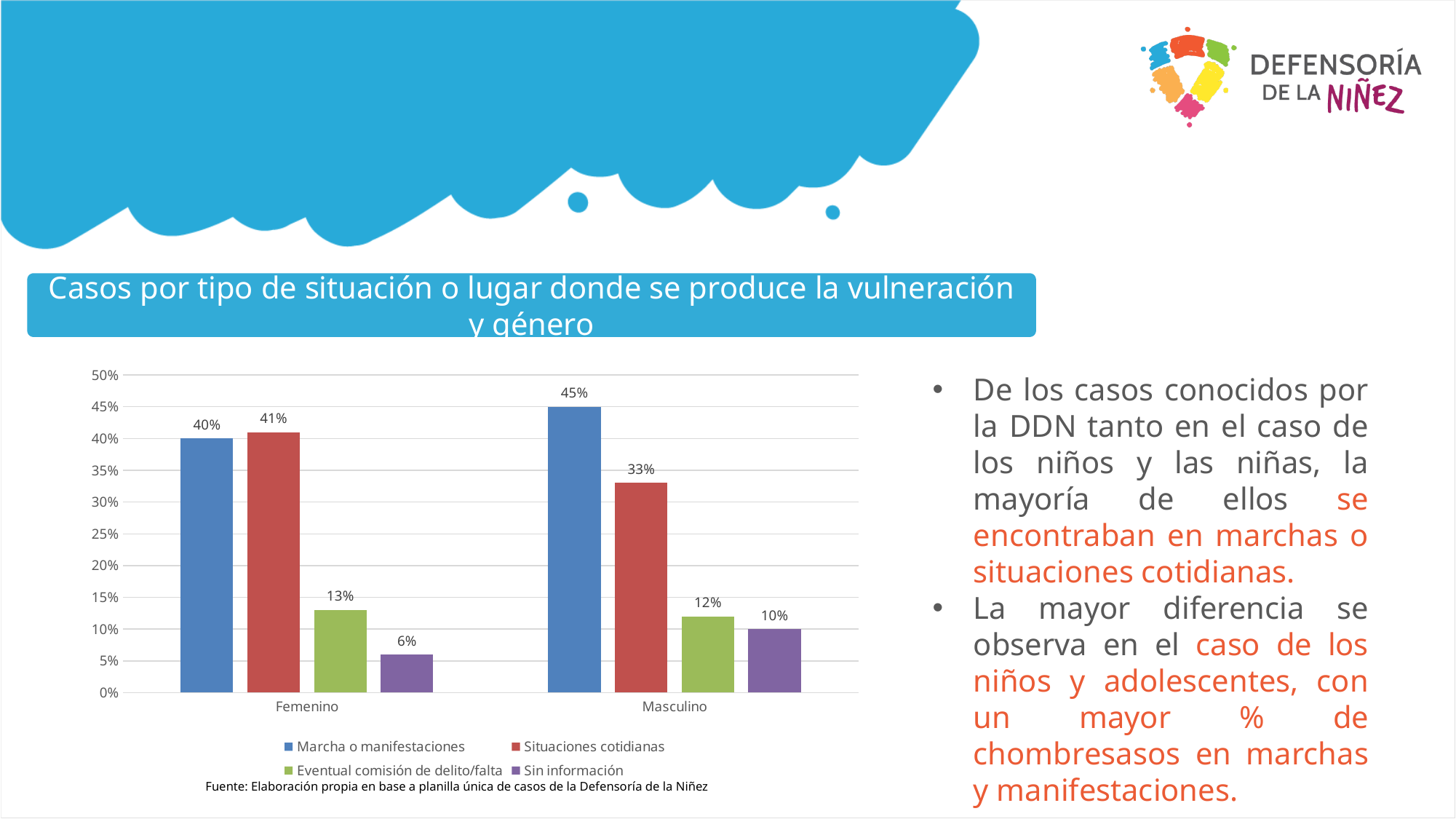
How many series does the legend list? 4 Which series has the highest value in the Masculino category? Marcha o manifestaciones What is the value for Situaciones cotidianas in the Masculino category? 33% Which series has the lowest value in the Femenino category? Sin información What is the value for Eventual comisión de delito/falta in the Masculino category? 12% What is the value for Sin información in the Femenino category? 6% Which is larger: Situaciones cotidianas for Femenino or for Masculino? Femenino What is the value for Marcha o manifestaciones in the Femenino category? 40% How many categories are shown on the x axis? 2 What is the difference between the Marcha o manifestaciones values for Masculino and Femenino? 5% What kind of chart is shown on the slide? Bar chart What colour are the bars for Situaciones cotidianas? Red